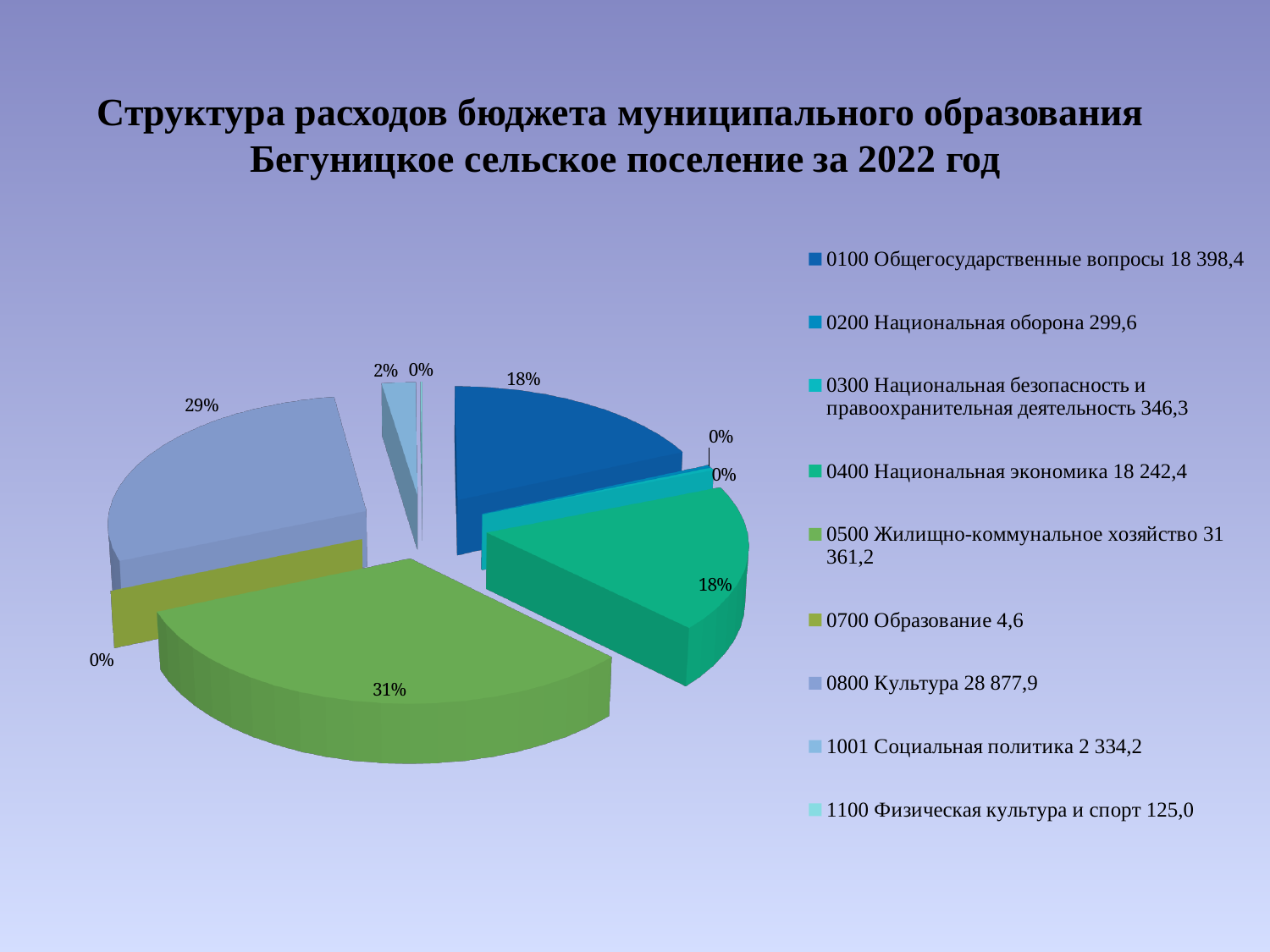
How many slices (categories) does the pie chart have according to the legend? 9 What year does the chart title say the budget expenditure structure refers to? 2022 What amount is shown in the legend for 0800 Культура? 28 877,9 What share of the pie does 0800 Культура have? 29% Which is larger: the share for 0800 Культура or the share for 0400 Национальная экономика? 0800 Культура What amount is shown in the legend for 0700 Образование? 4,6 What share of the pie does 0500 Жилищно-коммунальное хозяйство have? 31% What kind of chart is shown on the slide? pie chart What is the difference in percentage points between the share for 0500 Жилищно-коммунальное хозяйство and the share for 0100 Общегосударственные вопросы? 13 percentage points Which category has the largest share of the pie? 0500 Жилищно-коммунальное хозяйство What share of the pie does 0100 Общегосударственные вопросы have? 18%